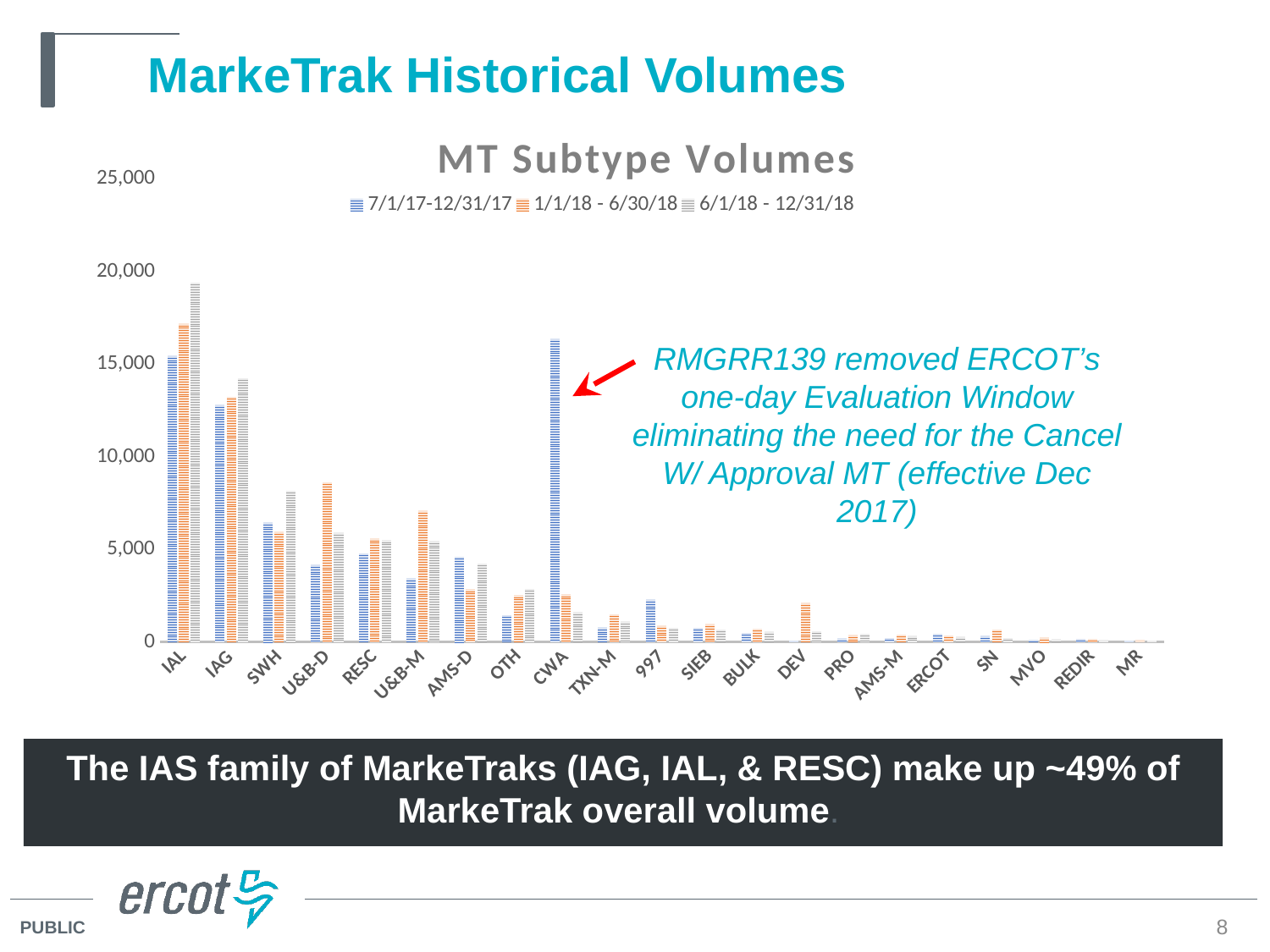
Is the value for DEV in the 1/1/18 - 6/30/18 series greater or less than 5,000? less Which category has the tallest bar in the chart? IAL Is the value for U&B-D in the 1/1/18 - 6/30/18 series greater or less than 5,000? greater Is the value for CWA in the 7/1/17-12/31/17 series greater or less than 15,000? greater Which category has the highest value for the 6/1/18 - 12/31/18 series? IAL What is the title of the chart? MT Subtype Volumes How many categories are shown along the x axis of the chart? 21 Do the values for CWA rise or fall across the three periods from 7/1/17-12/31/17 to 6/1/18 - 12/31/18? fall How many series does the chart's legend list? 3 For the 7/1/17-12/31/17 series, which is larger: IAL or IAG? IAL What kind of chart is shown on the slide? bar chart